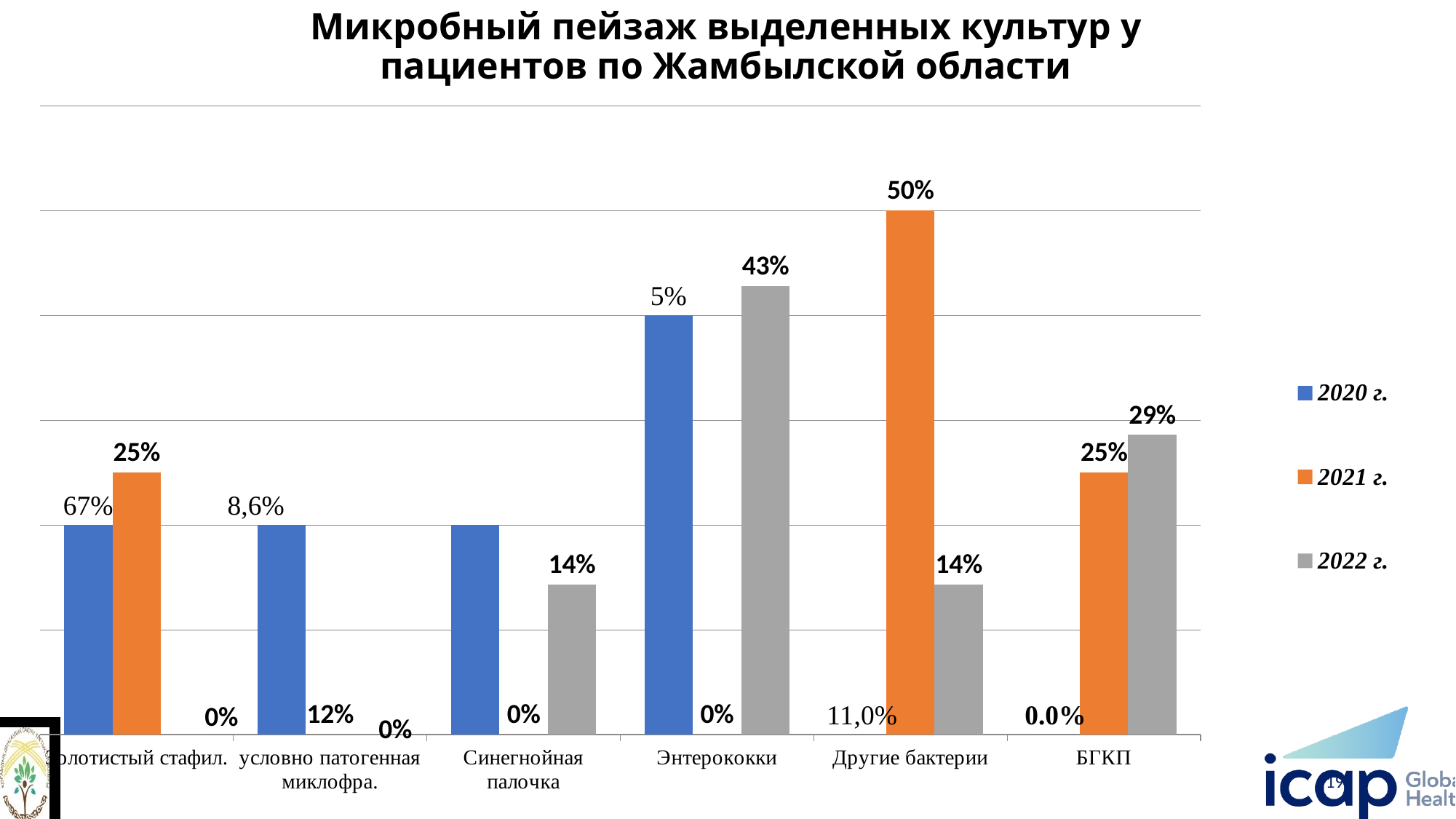
What is the value for Синегнойная палочка in the 2022 г. series? 14% What is the difference between the 2021 г. and 2022 г. values for Другие бактерии? 36 percentage points How many series does the legend list? 3 What is the value for Энтерококки in the 2022 г. series? 43% For БГКП, which is larger: the 2021 г. value or the 2022 г. value? 2022 г. What is the value for Другие бактерии in the 2021 г. series? 50% What type of chart is shown on the slide? bar chart Which category has the highest value in the 2022 г. series? Энтерококки What is the value for БГКП in the 2022 г. series? 29% Which category has the highest value in the 2021 г. series? Другие бактерии How many categories are shown on the x axis? 6